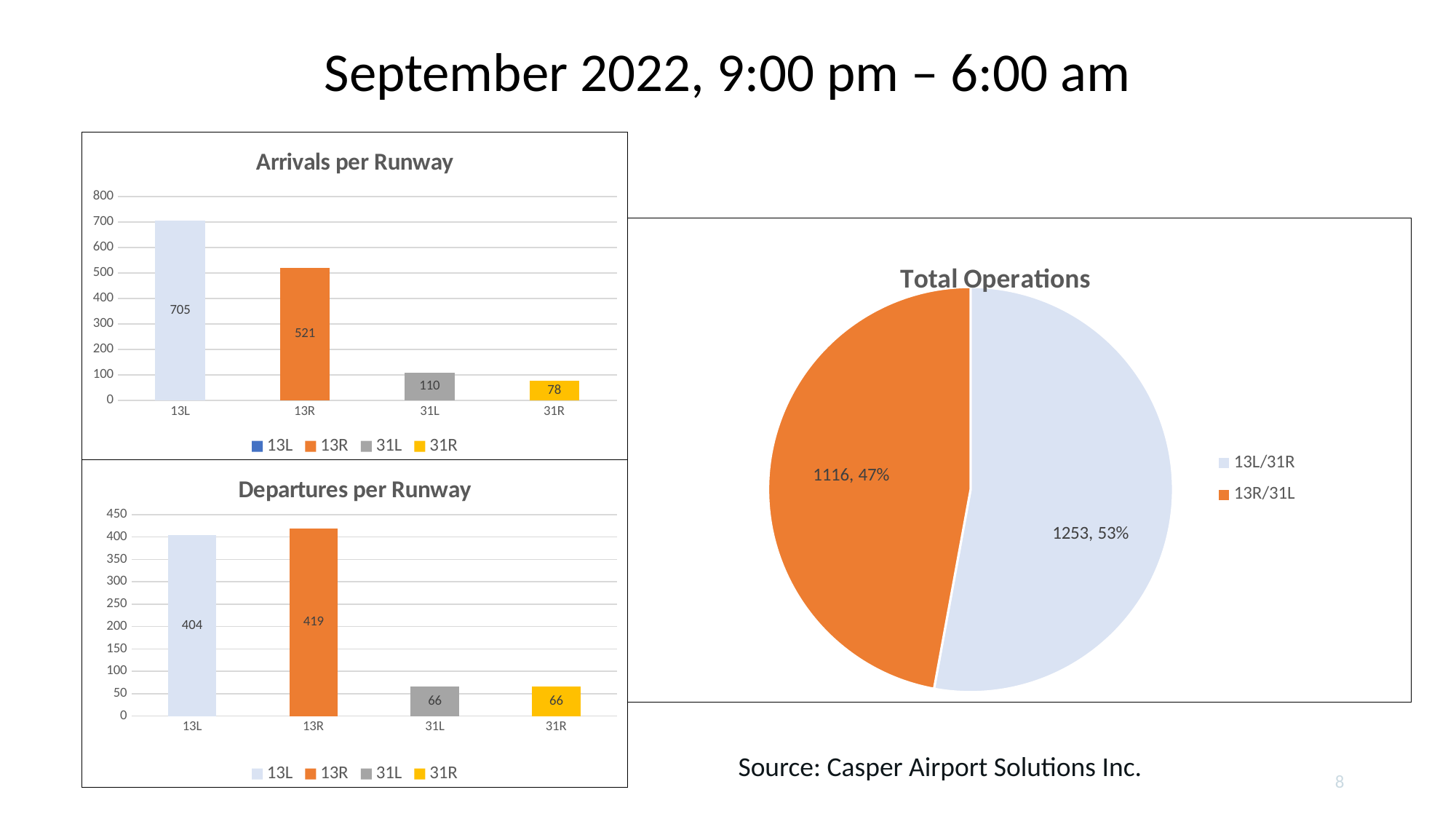
In the Departures per Runway chart, which runway has the highest number of departures? 13R In the Departures per Runway chart, which is larger, the value for 13L or 13R? 13R In the Departures per Runway chart, what is the value for runway 13R? 419 In the Total Operations chart, what is the value for 13L/31R? 1253 In the Total Operations chart, what share of operations is 13R/31L? 47% How many entries does the legend of the Total Operations chart list? 2 In the Arrivals per Runway chart, what is the difference between arrivals on 13L and 13R? 184 In the Departures per Runway chart, how many runway categories are shown on the x axis? 4 In the Arrivals per Runway chart, what is the value for runway 13L? 705 In the Arrivals per Runway chart, which runway has the lowest number of arrivals? 31R In the Arrivals per Runway chart, is the value for 31L greater or less than 200? less What kind of chart is the Total Operations chart? pie chart